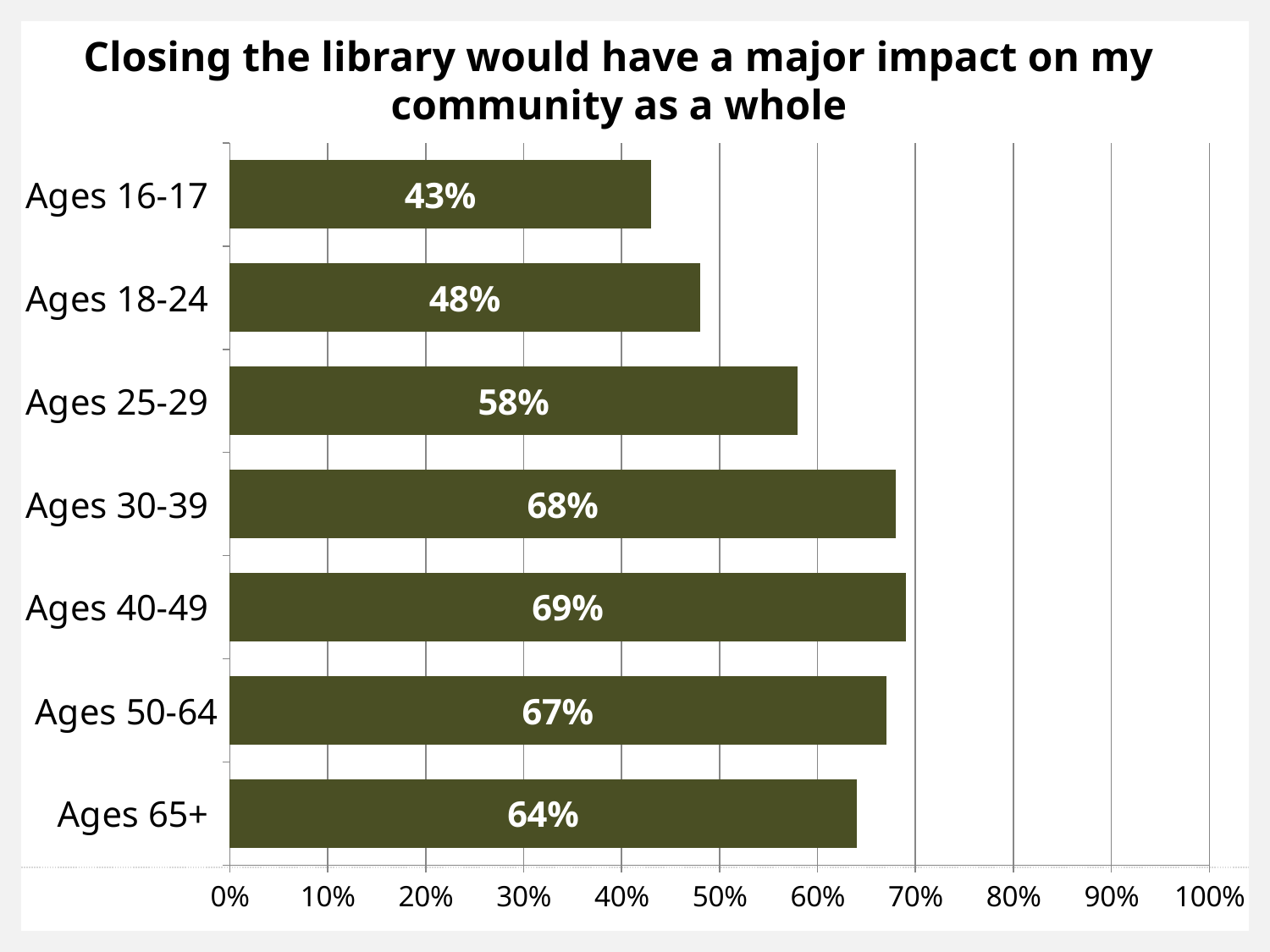
How many age groups are shown in the chart? 7 What kind of chart is shown on the slide? Bar chart Which age group has the lowest value? Ages 16-17 What is the value for Ages 16-17? 43% Which is larger, the value for Ages 50-64 or the value for Ages 65+? Ages 50-64 What is the value for Ages 65+? 64% What is the value for Ages 30-39? 68% Is the value for Ages 25-29 greater or less than 50%? greater Which age group has the highest value? Ages 40-49 What is the title of the chart? Closing the library would have a major impact on my community as a whole What is the difference between the values for Ages 25-29 and Ages 18-24? 10% What is the difference between the values for Ages 40-49 and Ages 16-17? 26%